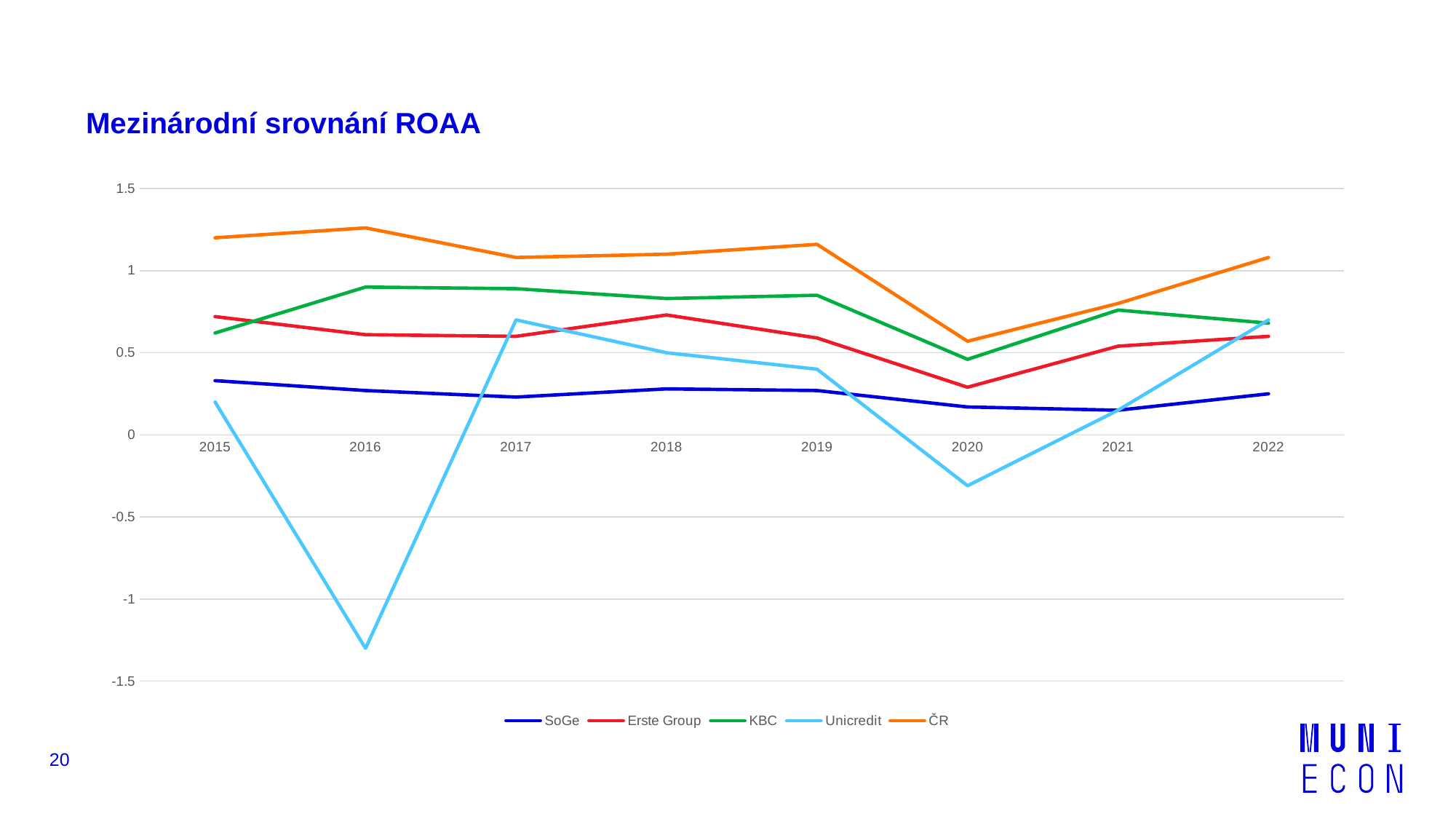
Is the value for Unicredit in 2016 greater or less than -1? less Which series has the lowest value in 2016? Unicredit What is the title of the chart? Mezinárodní srovnání ROAA Which series has the highest value in 2015? ČR What kind of chart is shown on the slide? Line chart Does the ČR line rise or fall from 2019 to 2020? Fall In 2020, which is higher: KBC or Erste Group? KBC How many series does the legend list? 5 How many years are shown on the x axis? 8 In which year does Unicredit reach its lowest value? 2016 Is the value for SoGe in 2021 greater or less than 0.5? less Is the value for ČR in 2016 greater or less than 1? greater